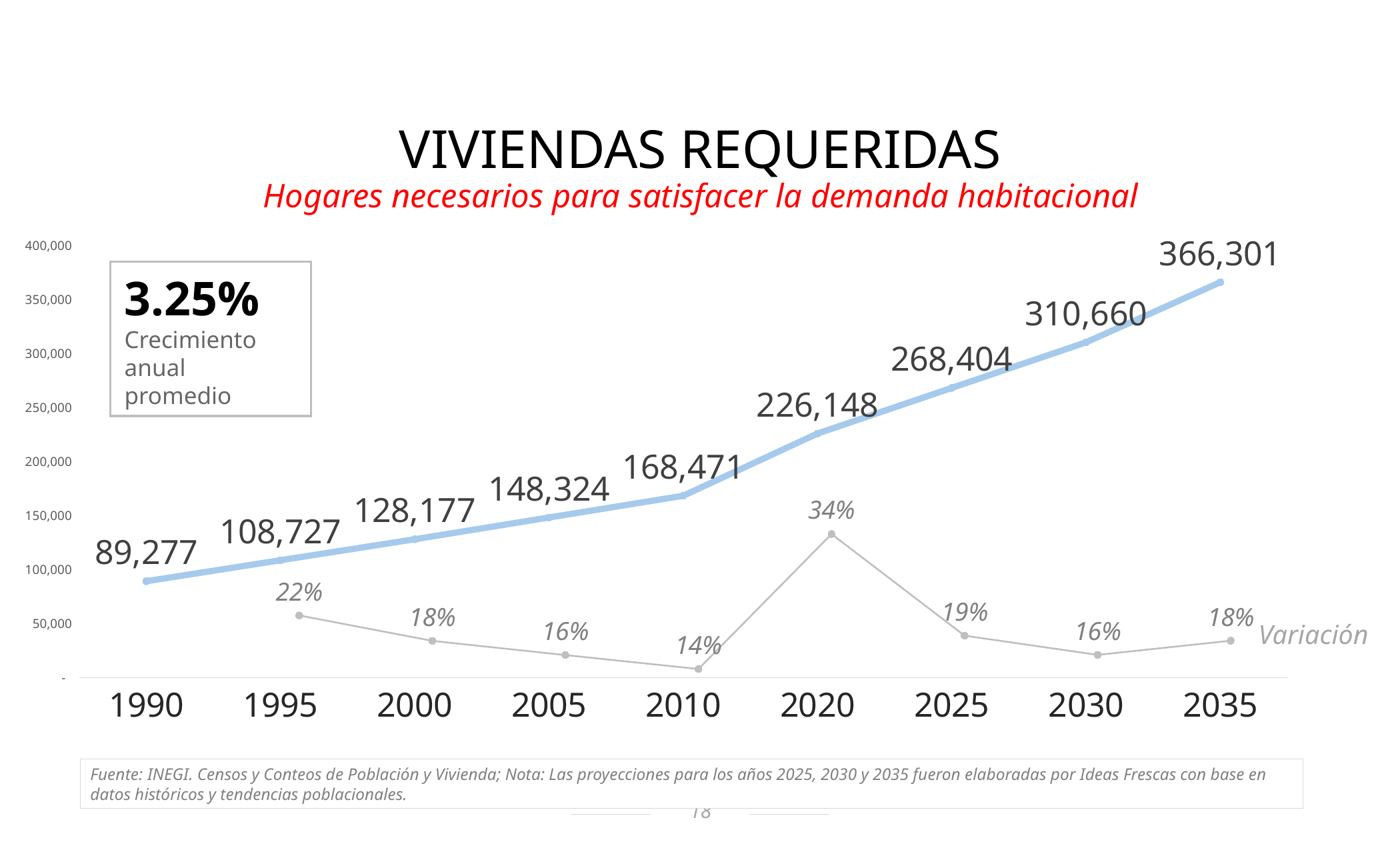
Which is larger, the Variación for 1995 or the Variación for 2025? 1995 Which year has the highest number of viviendas requeridas? 2035 What is the number of viviendas requeridas shown for 1990? 89,277 Do the viviendas requeridas values rise or fall from 1990 to 2035? Rise What is the number of viviendas requeridas shown for 2020? 226,148 Which year has the lowest Variación percentage? 2010 How many years are shown on the x axis of the chart? 9 What is the difference between the viviendas requeridas for 2035 and 2030? 55,641 What is the number of viviendas requeridas shown for 2035? 366,301 What Variación percentage is shown for 2020? 34% What is the difference between the viviendas requeridas for 2020 and 2010? 57,677 What kind of chart is shown on the slide? Line chart